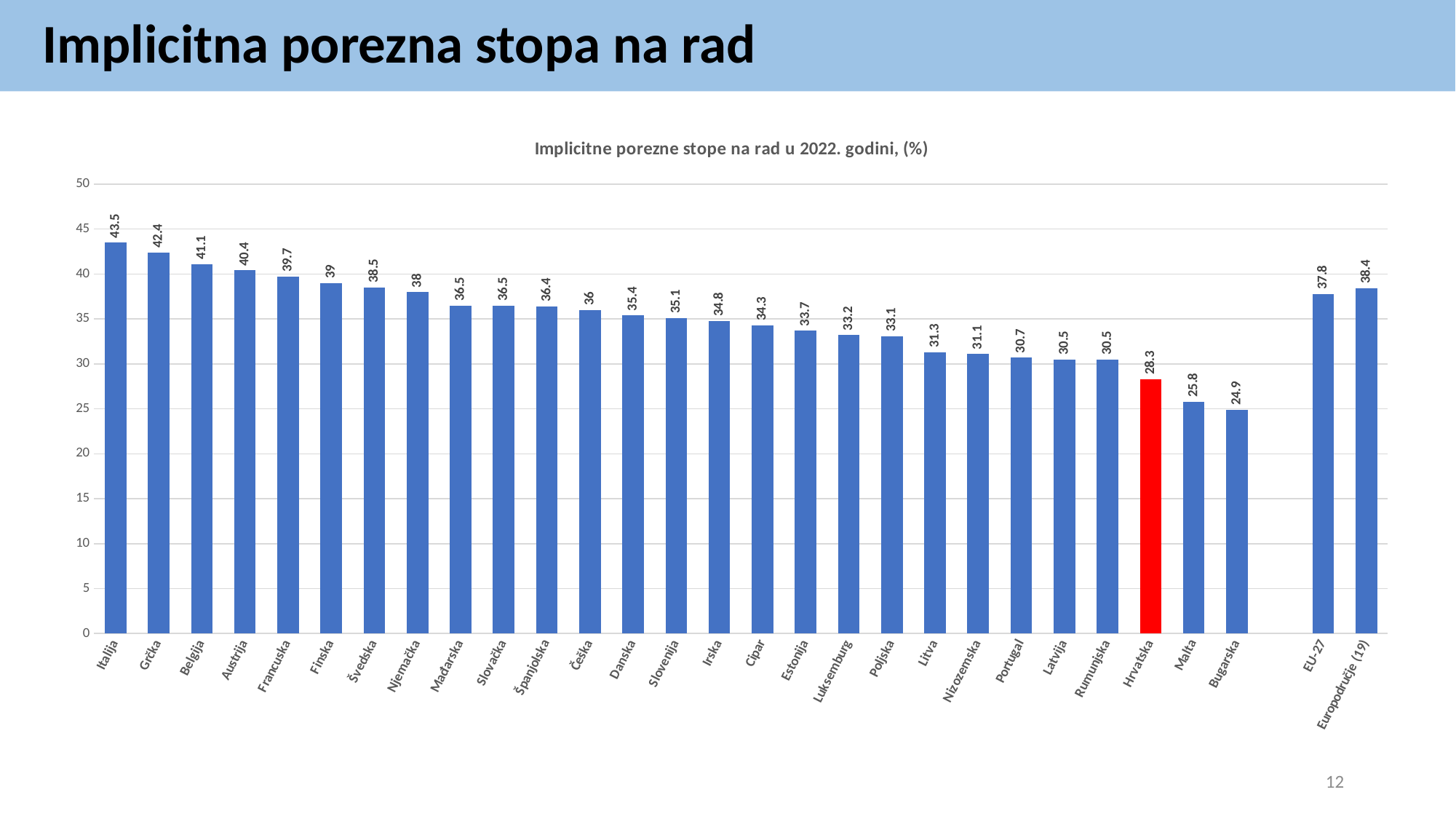
Which category has the highest value? Italija How many bars are plotted on the chart? 29 Is the value for Malta greater or less than 30? less What is the value for Hrvatska? 28.3 What kind of chart is shown on the slide? bar chart Which is larger, the value for Grčka or the value for Belgija? Grčka What is the difference between the values for EU-27 and Hrvatska? 9.5 What is the value for Europodručje (19)? 38.4 Which category's bar is coloured red? Hrvatska What is the value for EU-27? 37.8 Which category has the lowest value? Bugarska What is the difference between the values for Italija and Hrvatska? 15.2